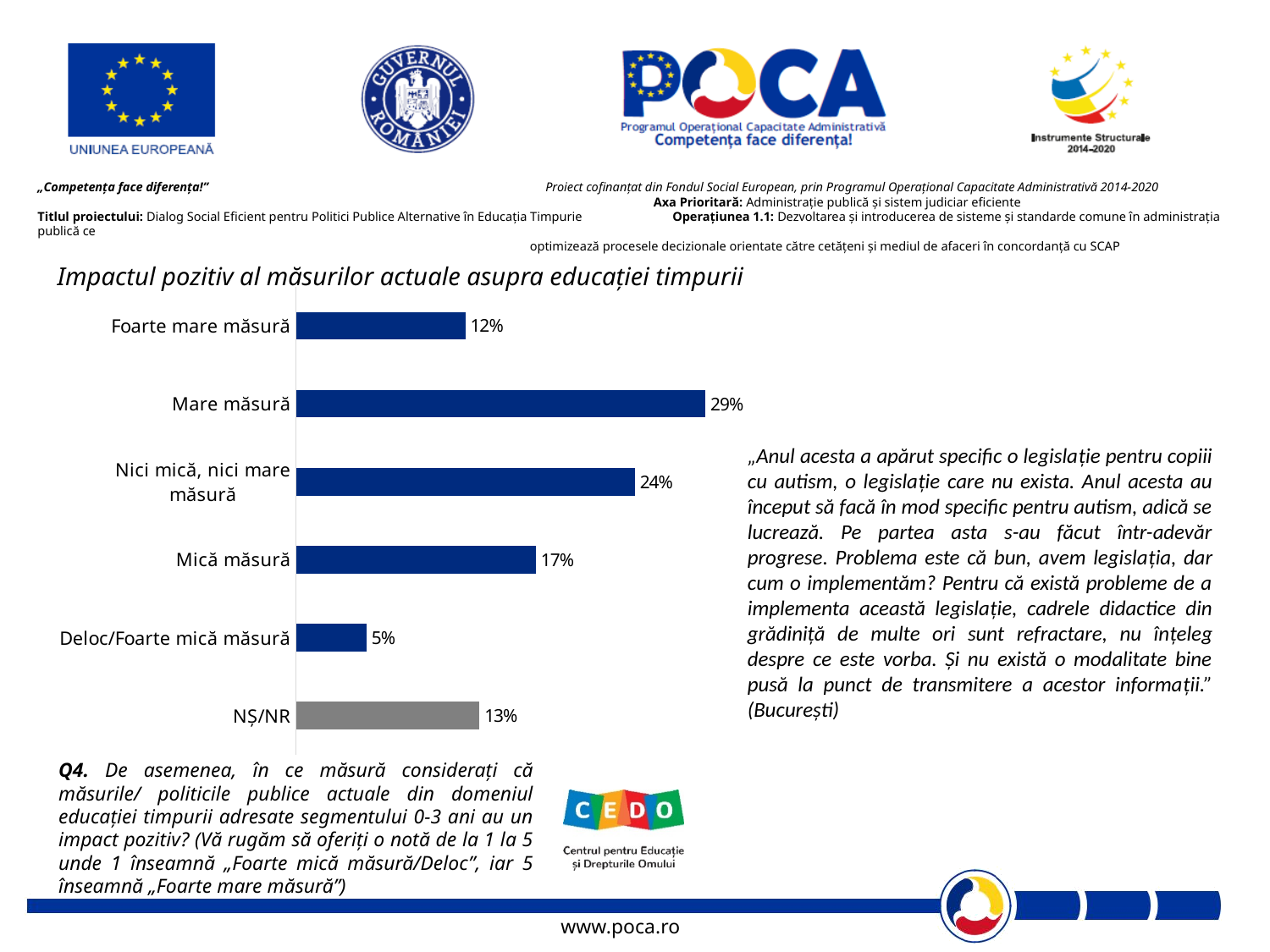
Which category has the lowest value? Deloc/Foarte mică măsură What kind of chart is shown on the slide? Bar chart Which category has the highest value? Mare măsură What is the value for "Deloc/Foarte mică măsură"? 5% How many categories are shown in the chart? 6 What is the value for "NȘ/NR"? 13% What is the difference between the values for "Mare măsură" and "Mică măsură"? 12% What is the title of the chart? Impactul pozitiv al măsurilor actuale asupra educației timpurii What is the value for "Nici mică, nici mare măsură"? 24% Which is larger, the value for "Foarte mare măsură" or the value for "NȘ/NR"? NȘ/NR Which bar is coloured differently (grey) from the others? NȘ/NR What is the value for "Mare măsură"? 29%